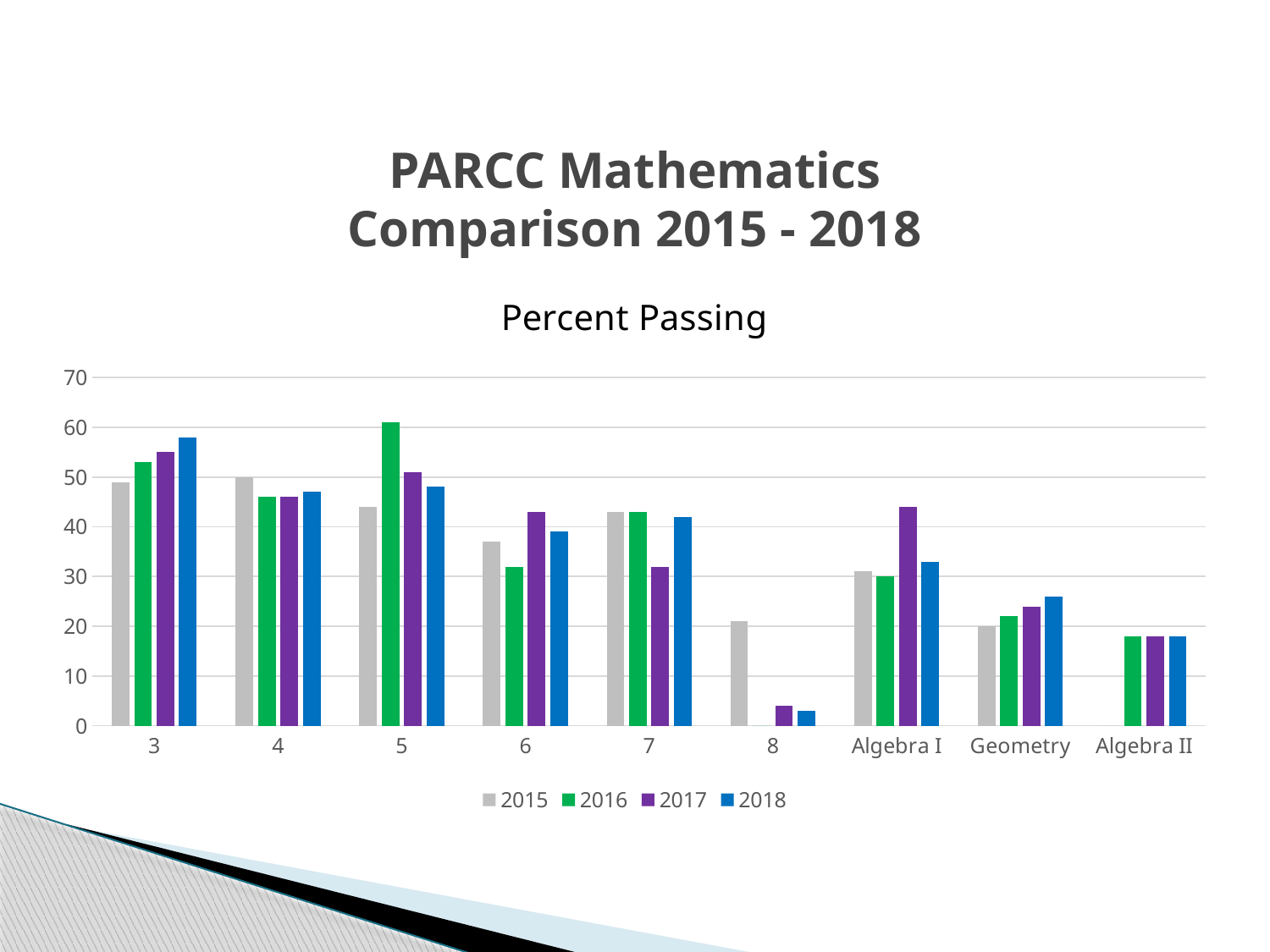
For grade 3, which year has the highest percent passing? 2018 For Algebra I, which year has the highest percent passing? 2017 For grade 6, which is larger, the 2015 value or the 2016 value? 2015 For Geometry, do the values rise or fall from 2015 to 2018? rise Which years are listed in the legend? 2015, 2016, 2017, 2018 Is the 2017 value for grade 8 greater or less than 10? less Is the 2016 value for grade 5 greater or less than 50? greater What kind of chart is shown on the slide? bar chart How many categories are shown along the x axis? 9 Is the 2017 value for grade 7 greater or less than 40? less What is the title of the chart? Percent Passing How many series does the legend list? 4